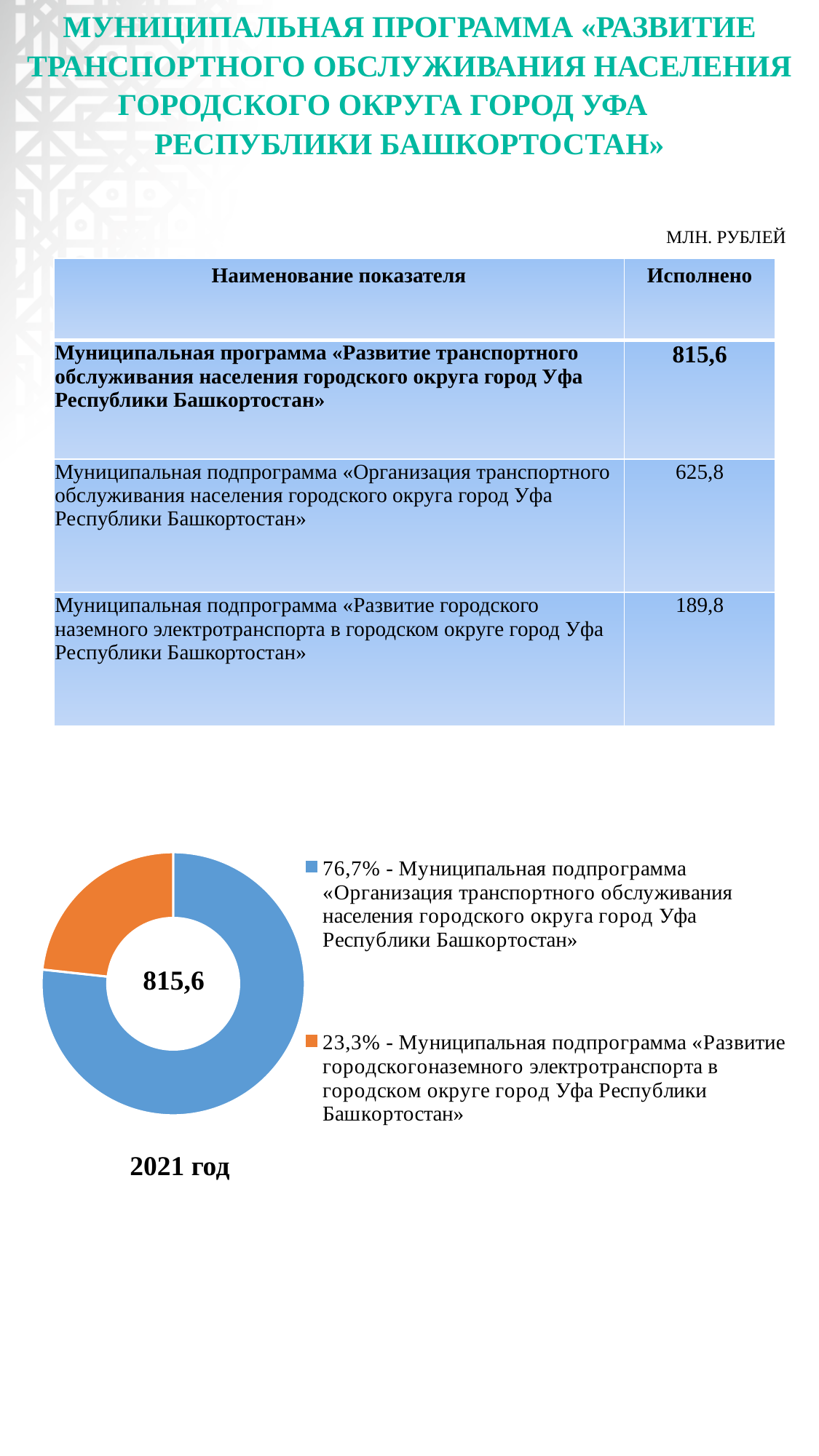
What share of the pie chart does the subprogram «Организация транспортного обслуживания населения городского округа город Уфа Республики Башкортостан» take? 76,7% In the pie chart, which slice is larger: «Организация транспортного обслуживания» or «Развитие городского наземного электротранспорта»? «Организация транспортного обслуживания» Which subprogram has the largest slice in the pie chart? Муниципальная подпрограмма «Организация транспортного обслуживания населения городского округа город Уфа Республики Башкортостан» How many entries does the legend of the pie chart list? 2 How many slices does the pie chart have? 2 Which year is the pie chart labelled with? 2021 год By how many percentage points does the share of «Организация транспортного обслуживания» exceed the share of «Развитие городского наземного электротранспорта» in the pie chart? 53,4 What colour is the slice for «Развитие городского наземного электротранспорта» in the pie chart? orange What value is printed in the centre of the pie chart? 815,6 What kind of chart is shown at the bottom of the slide? doughnut (pie) chart Which subprogram has the smallest slice in the pie chart? Муниципальная подпрограмма «Развитие городского наземного электротранспорта в городском округе город Уфа Республики Башкортостан» What share of the pie chart does the subprogram «Развитие городского наземного электротранспорта в городском округе город Уфа Республики Башкортостан» take? 23,3%